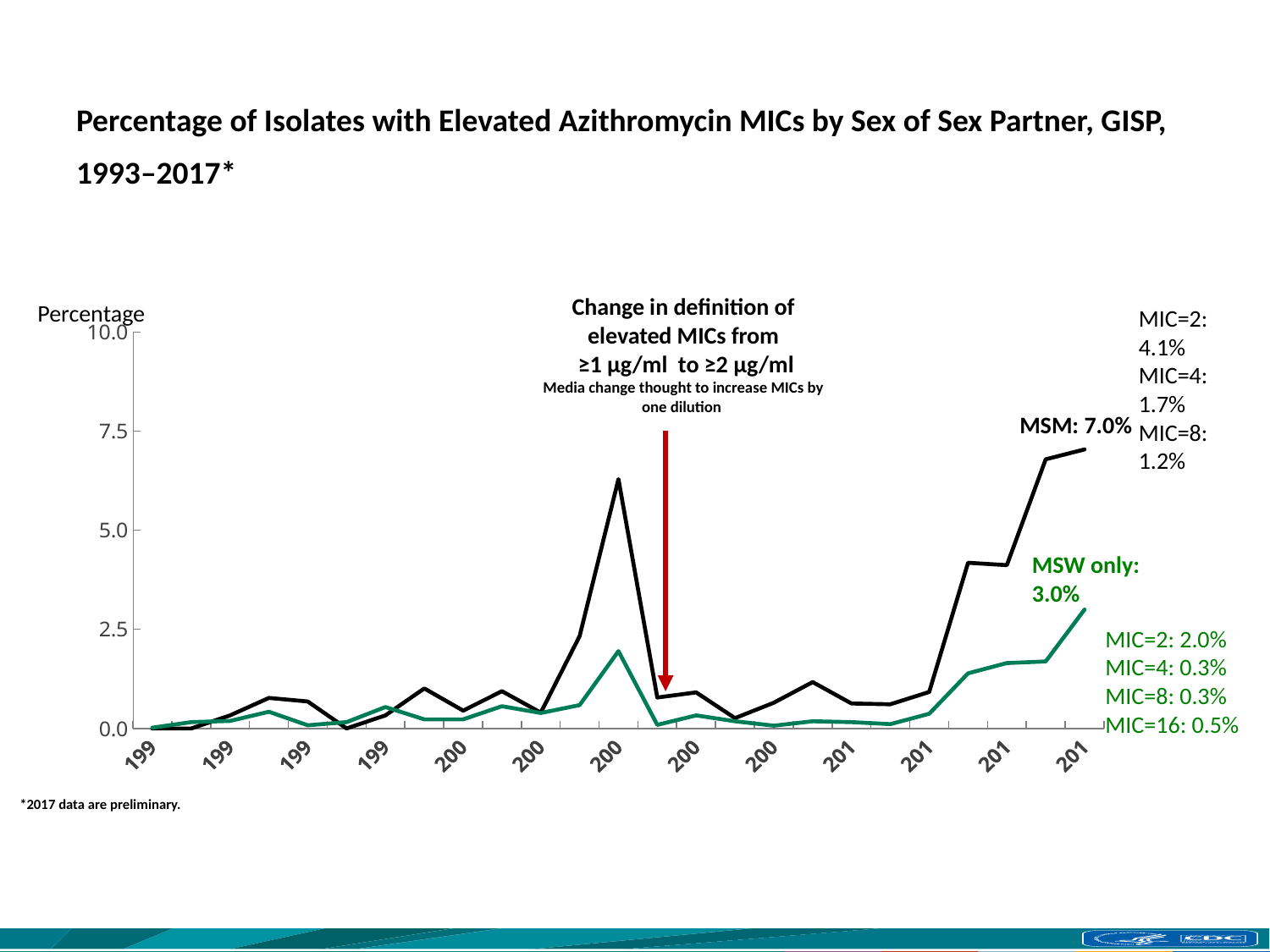
Is the highest peak of the MSM (black) line greater or less than 5.0? greater Is the highest point of the MSW only (green) line greater or less than 2.5? greater What percentage is given for MIC=16 among MSW only isolates? 0.5% What is the label on the y-axis of the chart? Percentage How many lines (series) are plotted on the chart? 2 What is the difference between the final MSM value (7.0%) and the final MSW only value (3.0%)? 4.0 percentage points At the end of the series, which group has the higher percentage of isolates with elevated azithromycin MICs, MSM or MSW only? MSM What percentage is given for MIC=2 among MSM isolates? 4.1% What is the final (2017) percentage labeled for the MSW only line? 3.0% What is the final (2017) percentage labeled for the MSM line? 7.0% What type of chart is shown on the slide? line chart Over the last several years shown, does the MSM line rise or fall? rise